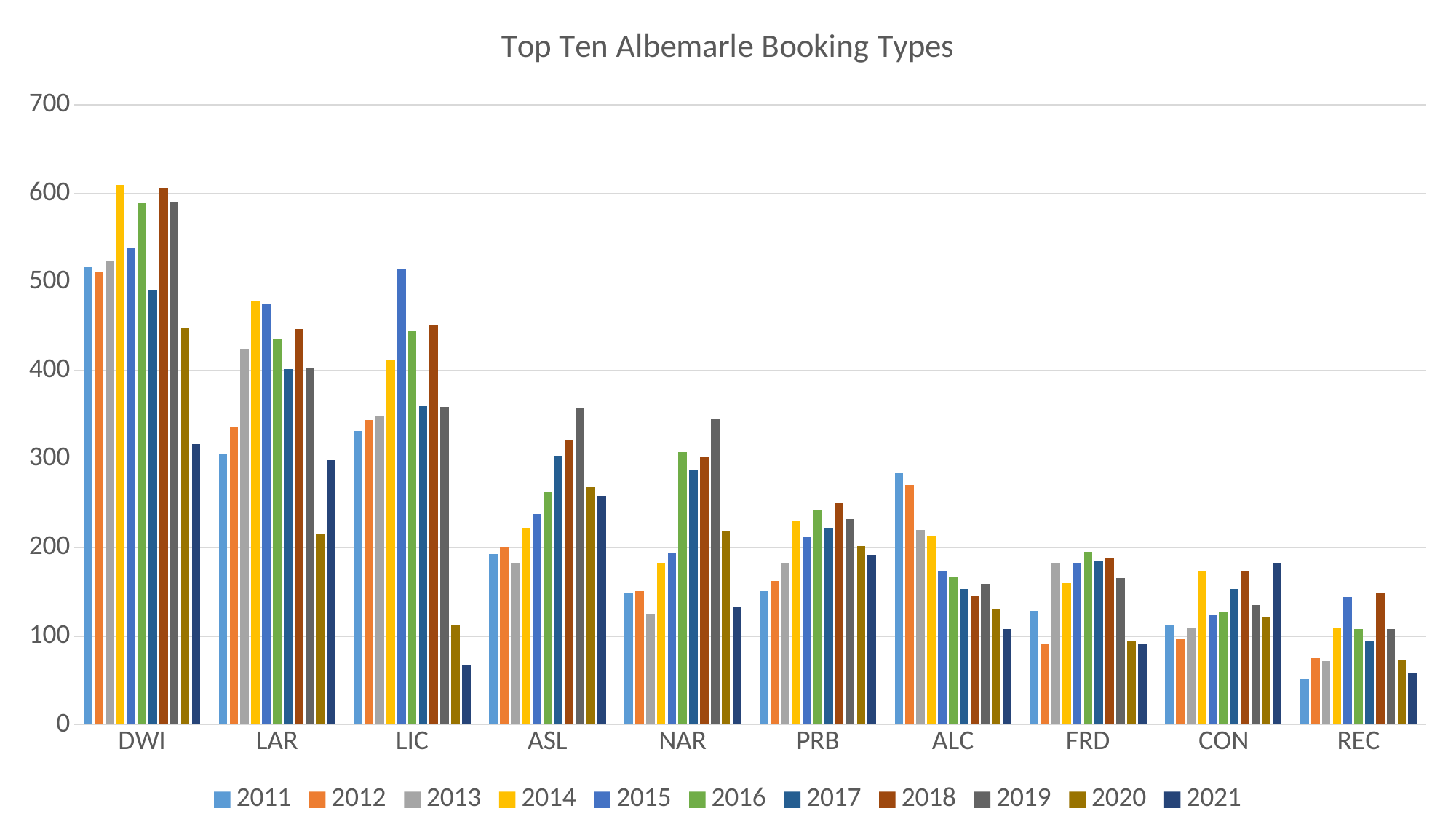
How many booking type categories are shown on the x axis? 10 Is the value for NAR in 2019 greater or less than 300? greater Is the value for REC in 2011 greater or less than 100? less Which category has the highest bar for 2014? DWI Which is larger, the 2011 value for ALC or the 2011 value for FRD? ALC How many series (years) does the legend list? 11 Is the value for DWI in 2021 greater or less than 300? greater Which year has the highest bar for LIC? 2015 What is the title of the chart? Top Ten Albemarle Booking Types What kind of chart is shown on the slide? bar chart Which year has the lowest bar for DWI? 2021